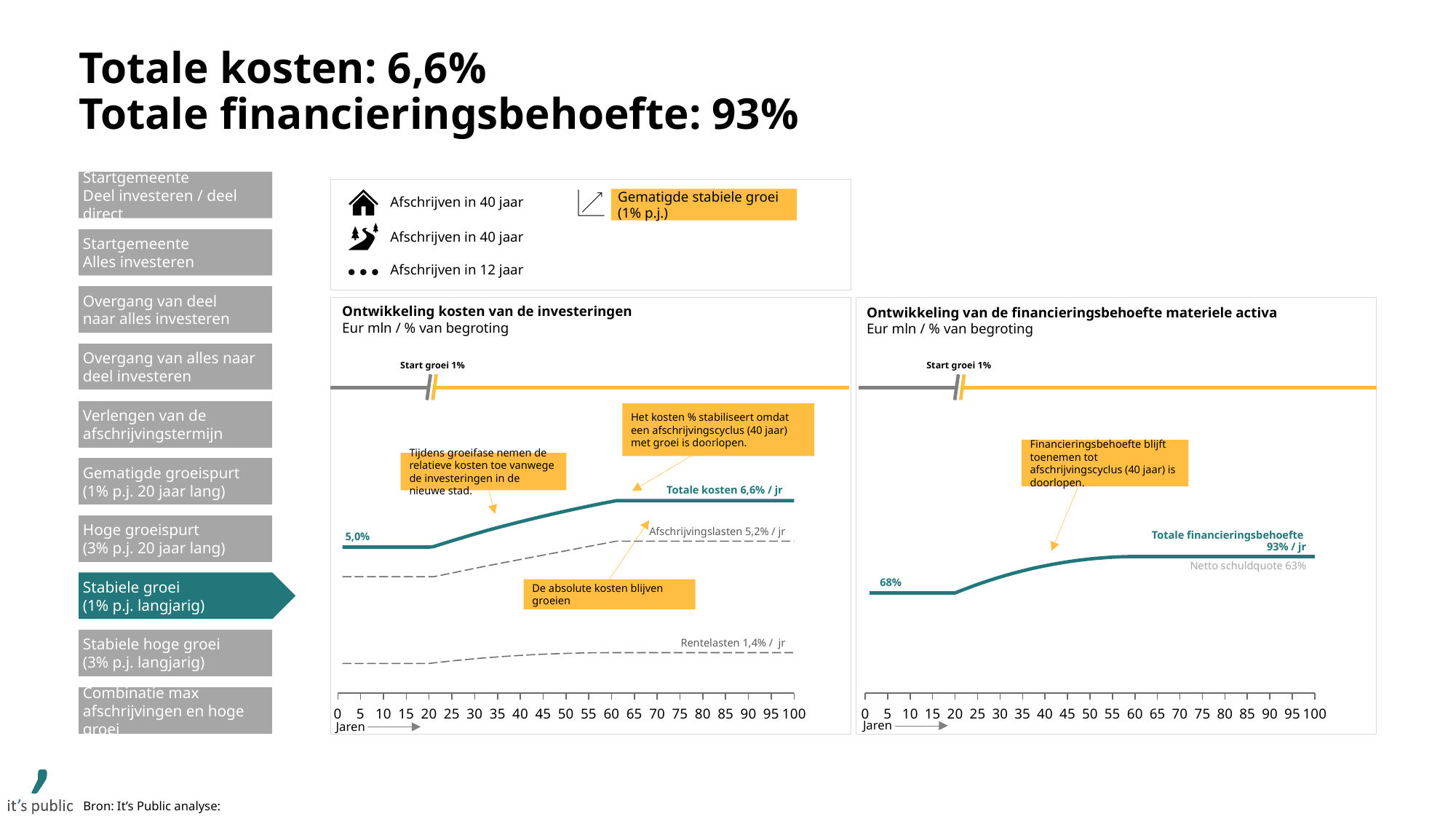
In the chart 'Ontwikkeling van de financieringsbehoefte materiele activa', what is the starting value of the Totale financieringsbehoefte line? 68% In the chart 'Ontwikkeling van de financieringsbehoefte materiele activa', does the Totale financieringsbehoefte line rise or fall over the years? rise In the chart 'Ontwikkeling kosten van de investeringen', what is the final value of the Totale kosten line? 6,6% / jr In the chart 'Ontwikkeling kosten van de investeringen', which line ends lower: Afschrijvingslasten or Rentelasten? Rentelasten In the chart 'Ontwikkeling van de financieringsbehoefte materiele activa', what is the final value of the Totale financieringsbehoefte line? 93% / jr In the chart 'Ontwikkeling kosten van de investeringen', what is the final value of the Afschrijvingslasten line? 5,2% / jr What is the unit shown on the x axis of both charts? Jaren In the chart 'Ontwikkeling kosten van de investeringen', by how much does the Totale kosten line rise from its start value to its final value? 1,6% In the chart 'Ontwikkeling kosten van de investeringen', what is the final value of the Rentelasten line? 1,4% / jr In the chart 'Ontwikkeling kosten van de investeringen', what is the starting value of the Totale kosten line? 5,0% What type of chart is 'Ontwikkeling kosten van de investeringen'? line chart In the chart 'Ontwikkeling van de financieringsbehoefte materiele activa', what is the Netto schuldquote shown? 63%